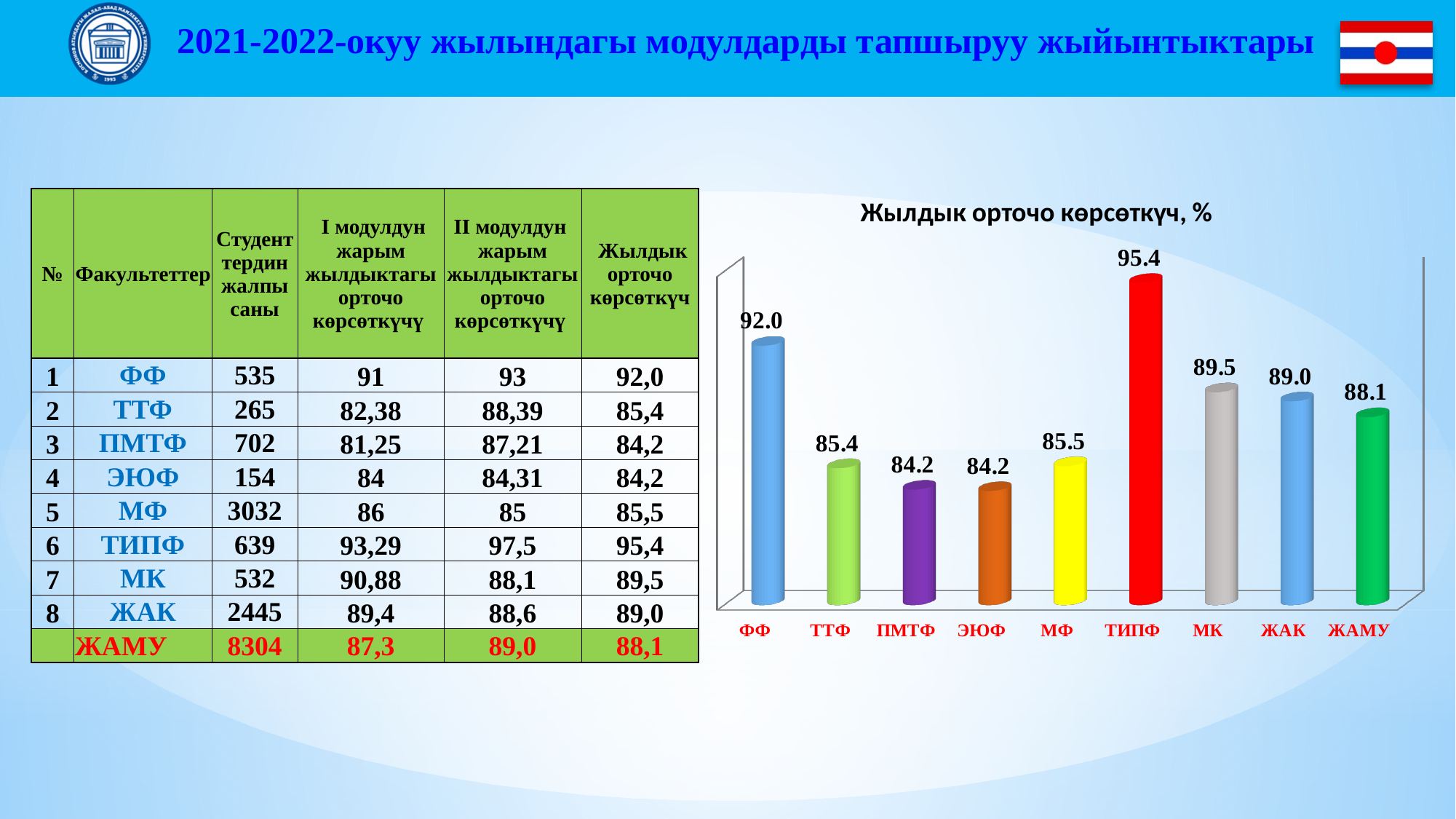
How many categories (bars) are shown in the chart? 9 What is the difference between the values for МК and ЖАК in the chart? 0.5 What is the difference between the values for ТИПФ and ФФ in the chart? 3.4 What is the value shown for ТИПФ in the chart? 95.4 What kind of chart is shown on the slide? bar chart What is the title of the chart? Жылдык орточо көрсөткүч, % What is the value shown for ЖАМУ in the chart? 88.1 What is the value shown for ФФ in the chart? 92.0 Which is larger in the chart, the value for ФФ or the value for ЖАМУ? ФФ Which category has the highest value in the chart? ТИПФ What is the value shown for МК in the chart? 89.5 Which is larger in the chart, the value for ТТФ or the value for МК? МК